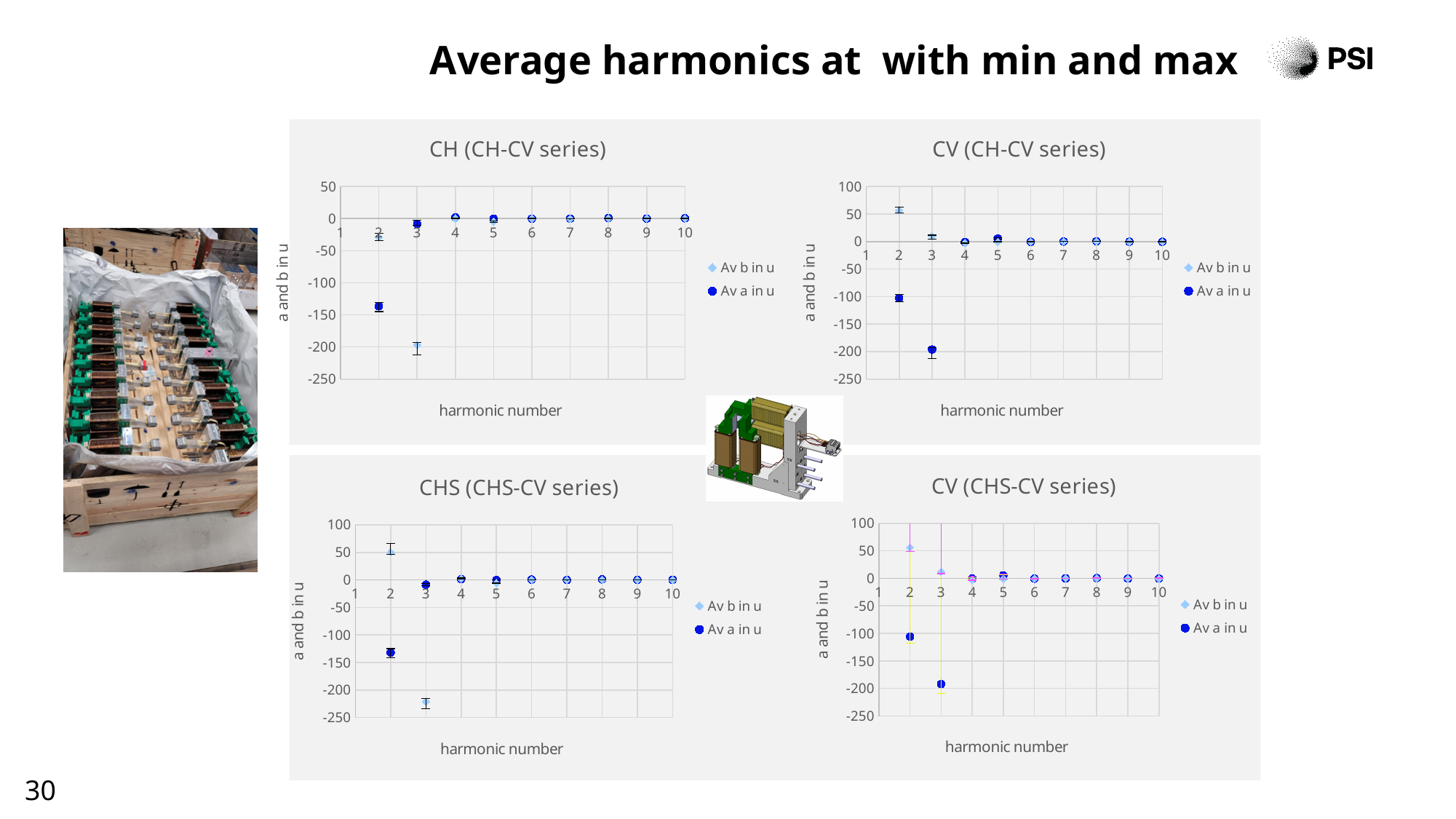
In the CH (CH-CV series) chart, at which harmonic number is the Av b in u value lowest? 3 In the CH (CH-CV series) chart, is the Av b in u value at harmonic number 3 greater or less than -150? less In the CV (CH-CV series) chart, is the Av b in u value at harmonic number 2 greater or less than 50? greater What is the x-axis label on the CV (CHS-CV series) chart? harmonic number In the CV (CHS-CV series) chart, is the Av a in u value at harmonic number 2 greater or less than -50? less What are the two legend entries on the CHS (CHS-CV series) chart? Av b in u and Av a in u How many series does the legend of the CV (CH-CV series) chart list? 2 In the CH (CH-CV series) chart, at harmonic number 2, which is larger: Av a in u or Av b in u? Av b in u In the CV (CH-CV series) chart, at which harmonic number is the Av a in u value lowest? 3 What kind of chart is the CH (CH-CV series) chart? scatter chart